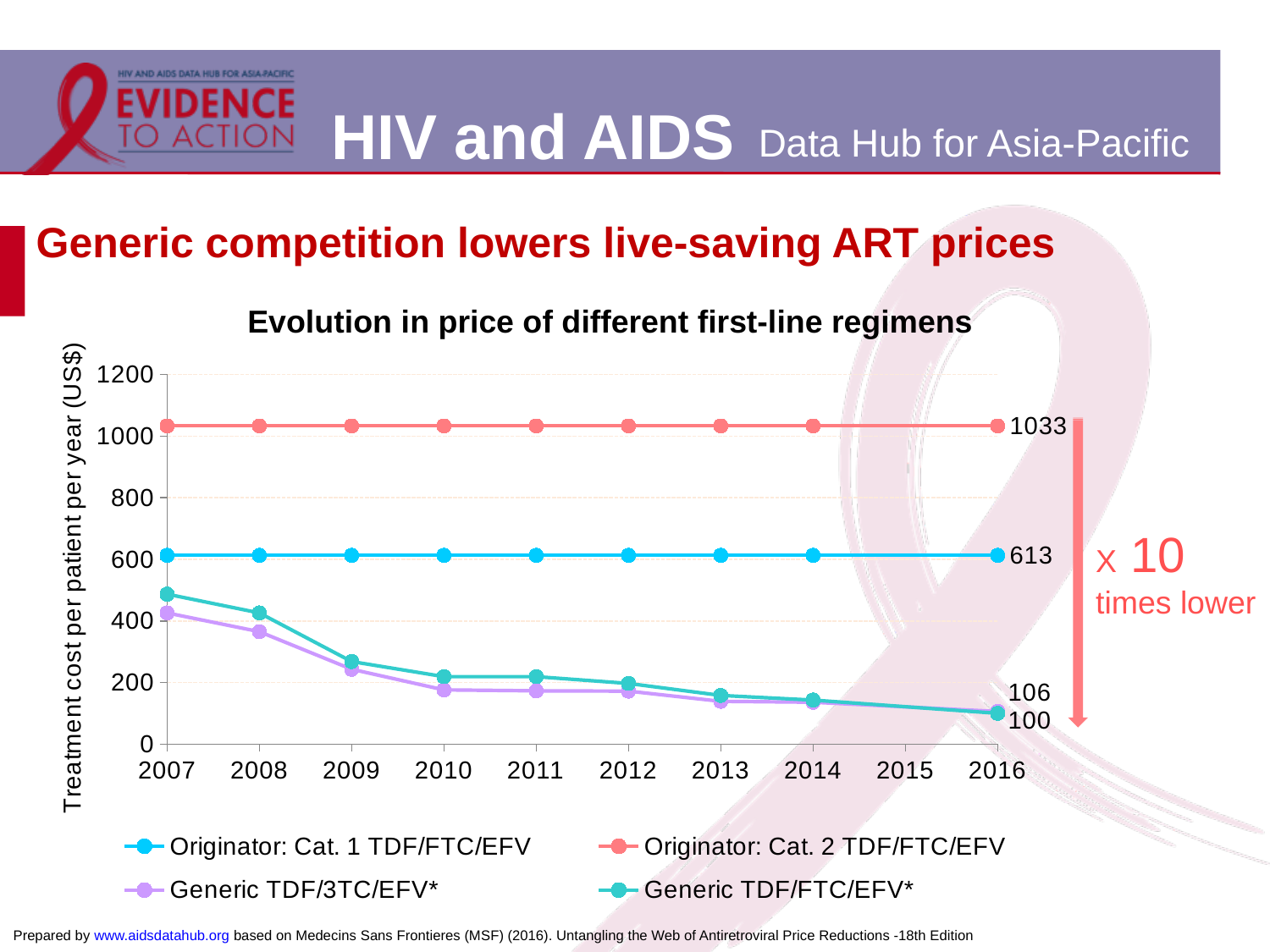
Is the value for Generic TDF/FTC/EFV* in 2007 greater or less than 400? greater What kind of chart is shown on the slide? line chart Which series has the highest treatment cost in 2016? Originator: Cat. 2 TDF/FTC/EFV What is the treatment cost per patient per year for Originator: Cat. 2 TDF/FTC/EFV in 2016? 1033 Is the value for Generic TDF/3TC/EFV* in 2010 greater or less than 200? less What is the title of the chart? Evolution in price of different first-line regimens How many years are shown along the x axis of the chart? 10 How many series does the chart legend list? 4 What is the difference between the 2016 prices of Originator: Cat. 2 TDF/FTC/EFV and Originator: Cat. 1 TDF/FTC/EFV? 420 Does the price of Generic TDF/FTC/EFV* rise or fall from 2007 to 2016? fall What is the treatment cost per patient per year for Originator: Cat. 1 TDF/FTC/EFV in 2016? 613 Which is larger in 2016, the price of Originator: Cat. 1 TDF/FTC/EFV or Generic TDF/FTC/EFV*? Originator: Cat. 1 TDF/FTC/EFV